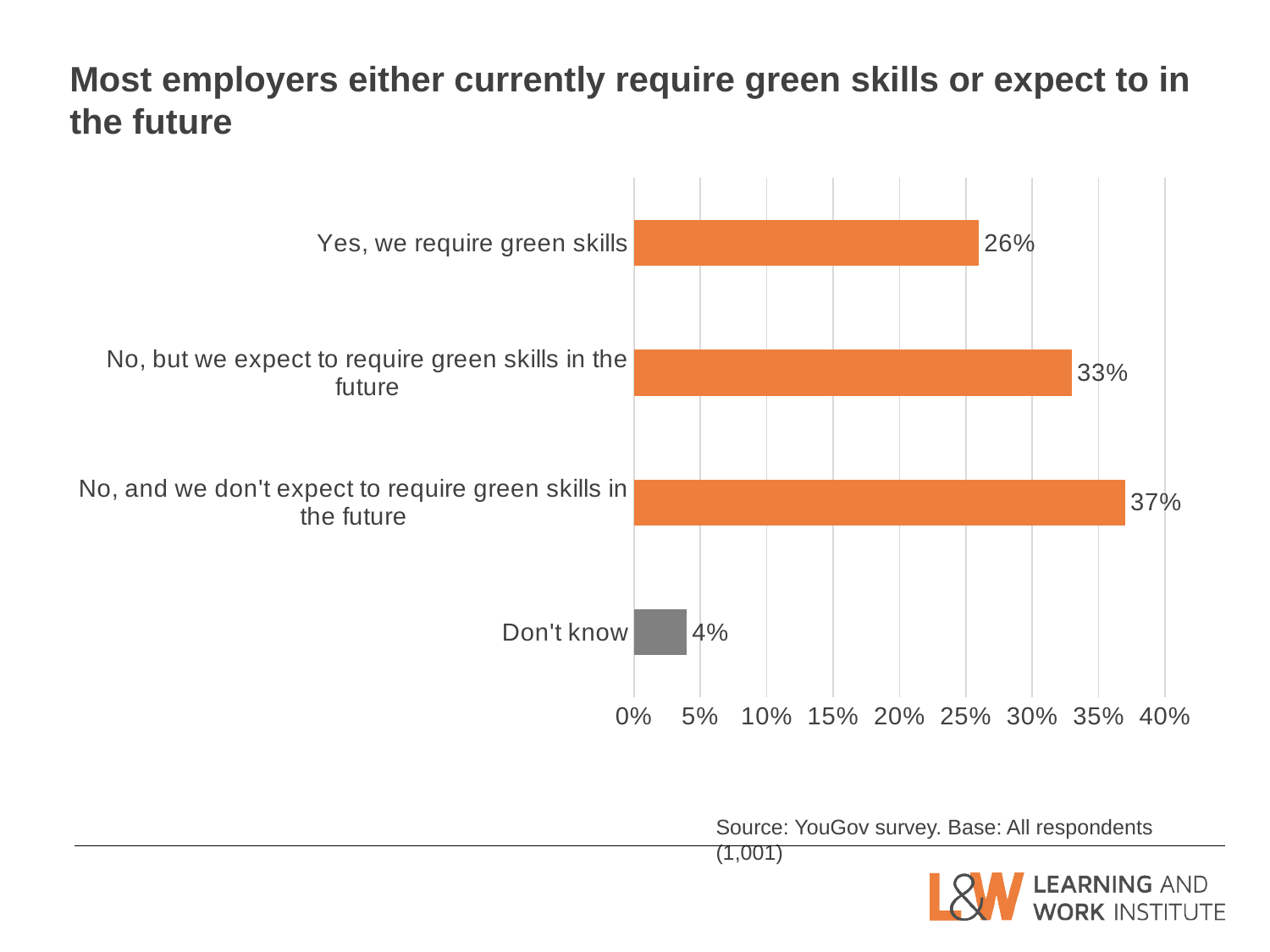
Which bar is coloured grey rather than orange? Don't know How many categories are shown in the chart? 4 Is the value for "Yes, we require green skills" greater or less than 30%? less What kind of chart is shown on the slide? Bar chart What is the difference between "No, and we don't expect to require green skills in the future" and "Yes, we require green skills"? 11 percentage points What is the title of the slide? Most employers either currently require green skills or expect to in the future Which category has the highest value? No, and we don't expect to require green skills in the future What is the value for "Don't know"? 4% What percentage of employers say "Yes, we require green skills"? 26% Which is larger: "Yes, we require green skills" or "No, but we expect to require green skills in the future"? No, but we expect to require green skills in the future Which category has the lowest value? Don't know What is the value for "No, but we expect to require green skills in the future"? 33%